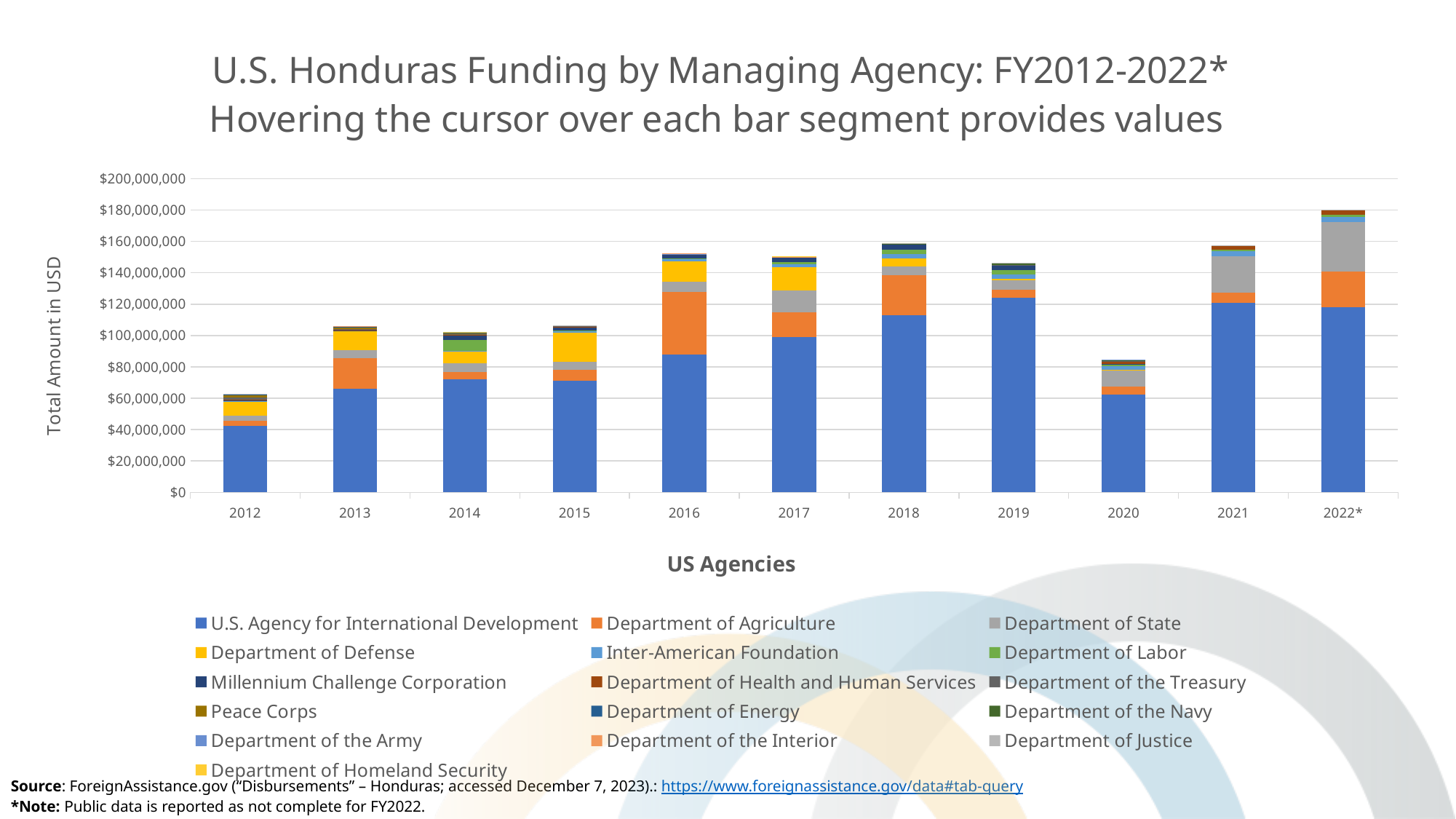
Which year has a larger total funding bar, 2018 or 2020? 2018 How many fiscal years (bars) are shown on the x axis? 11 What kind of chart is shown on the slide? Stacked bar chart Which year has the highest total funding bar? 2022* Do the total funding bars rise or fall from 2012 to 2016? rise Is the total funding for 2016 greater or less than $140,000,000? greater Which year has the lowest total funding bar? 2012 How many agencies does the legend list? 16 What is the title of the vertical axis? Total Amount in USD Is the total funding for 2012 greater or less than $80,000,000? less Is the total funding for 2022* greater or less than $160,000,000? greater